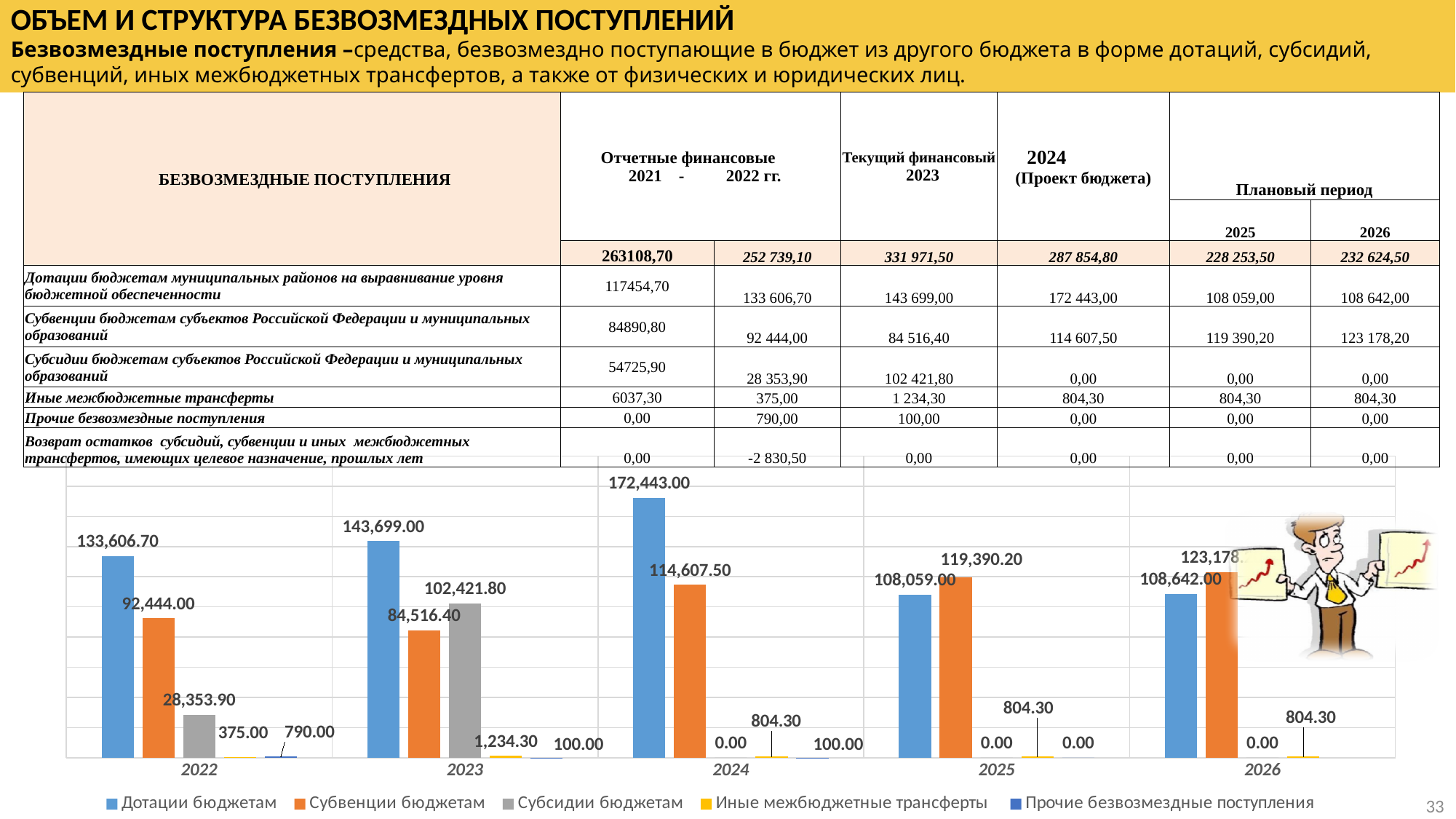
In the bar chart, do the values for Субвенции бюджетам rise or fall from 2023 to 2026? Rise In the bar chart, what is the value of Субсидии бюджетам for 2023? 102,421.80 How many series does the legend of the bar chart list? 5 In the bar chart, what is the value of Субвенции бюджетам for 2024? 114,607.50 In the bar chart, what is the difference between Дотации бюджетам and Субвенции бюджетам in 2024? 57,835.50 In the bar chart, what is the value of Иные межбюджетные трансферты for 2025? 804.30 In the bar chart, what is the value of Дотации бюджетам for 2022? 133,606.70 What type of chart is shown at the bottom of the slide? Bar chart In the bar chart, which is larger in 2025: Дотации бюджетам or Субвенции бюджетам? Субвенции бюджетам How many years are shown on the x axis of the bar chart? 5 In the bar chart, in which year is Дотации бюджетам lowest? 2025 In the bar chart, in which year is Дотации бюджетам highest? 2024